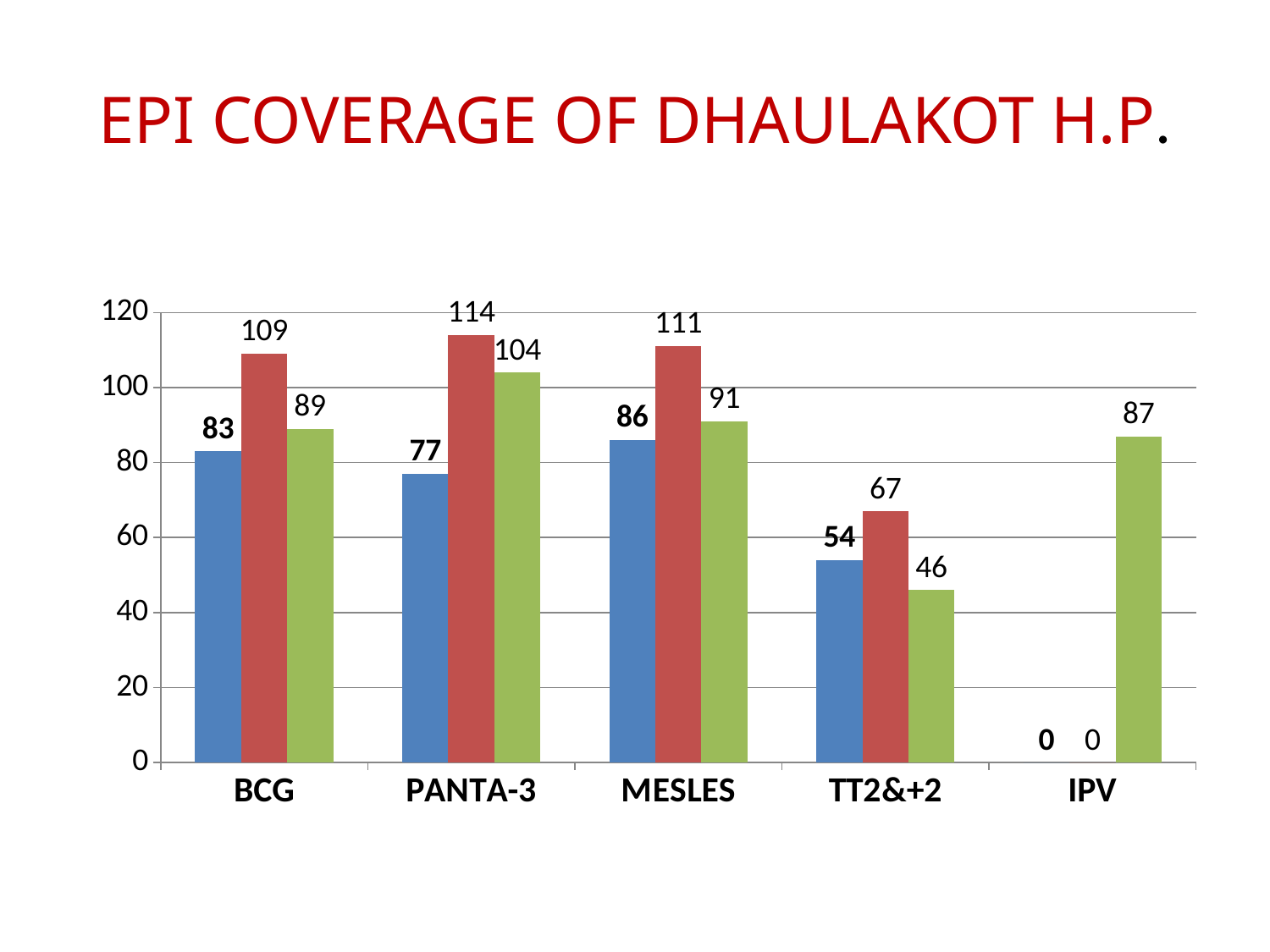
What kind of chart is shown on the slide? bar chart What is the value of the green bar for TT2&+2? 46 Is the value of the red bar for TT2&+2 greater or less than 80? less What is the value of the red bar for PANTA-3? 114 Which category has the lowest green bar? TT2&+2 How many categories are shown on the x axis? 5 What is the title of the slide? EPI COVERAGE OF DHAULAKOT H.P. What is the value of the blue bar for BCG? 83 What is the value of the green bar for IPV? 87 Which category has the highest red bar? PANTA-3 Which is larger for BCG, the red bar or the green bar? the red bar What is the difference between the red and blue bars for MESLES? 25